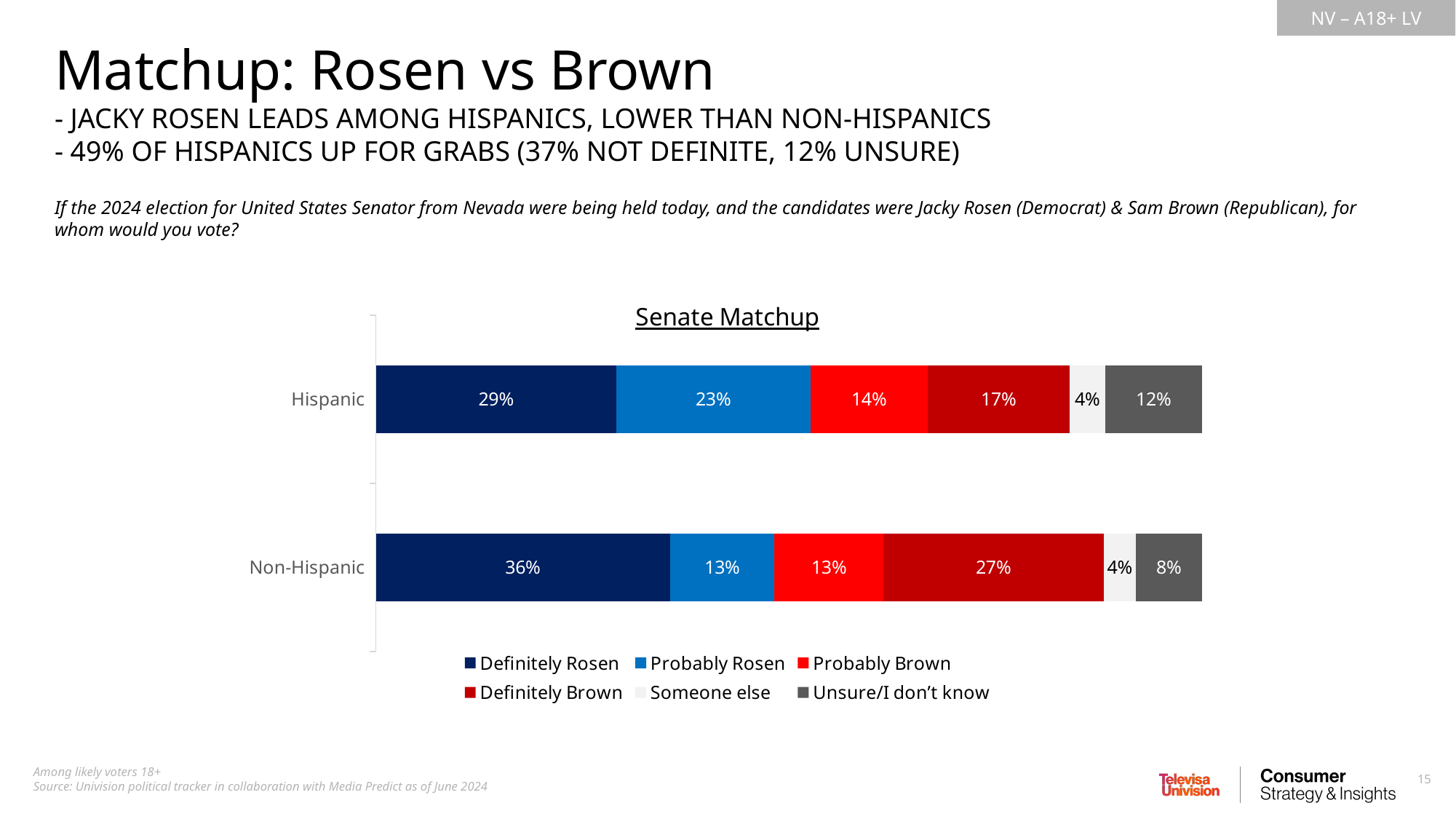
Which group has the higher share of Probably Rosen, Hispanic or Non-Hispanic? Hispanic What is the combined share of Definitely Rosen and Probably Rosen among Hispanic respondents? 52% What kind of chart is shown on the slide? Stacked bar chart What percentage of Non-Hispanic respondents said Probably Rosen? 13% How many categories (groups) are shown on the chart? 2 How many series does the legend list? 6 What percentage of Hispanic respondents said Definitely Rosen? 29% Which group has the higher share of Definitely Rosen, Hispanic or Non-Hispanic? Non-Hispanic What percentage of Non-Hispanic respondents said Definitely Brown? 27% What is the difference between the Definitely Brown share for Non-Hispanic and Hispanic respondents? 10 percentage points What is the title of the chart? Senate Matchup What percentage of Hispanic respondents said Unsure/I don't know? 12%